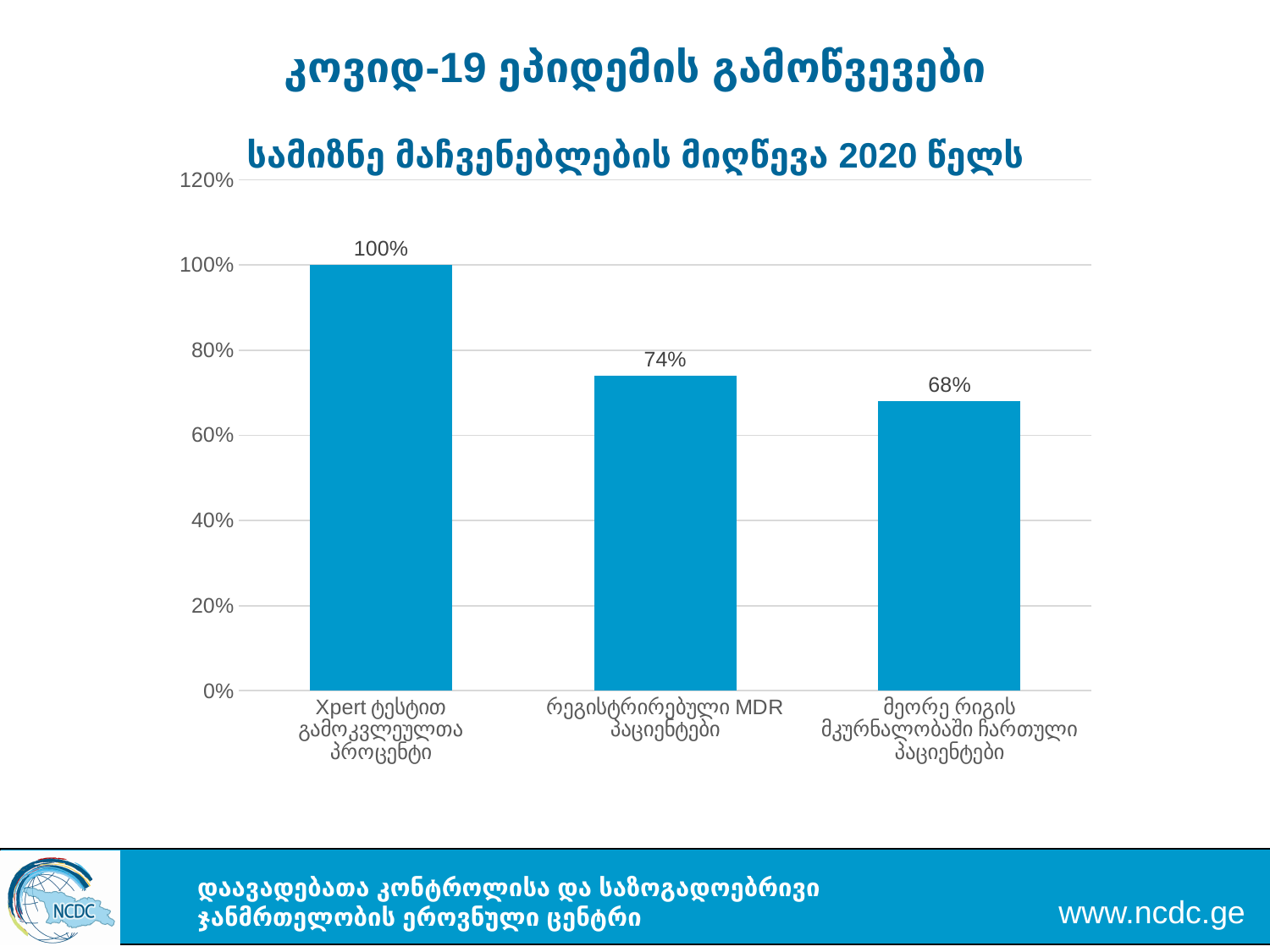
Which category has the lowest value? მეორე რიგის მკურნალობაში ჩართული პაციენტები Which category has the highest value? Xpert ტესტით გამოკვლეულთა პროცენტი What is the difference between the values for "Xpert ტესტით გამოკვლეულთა პროცენტი" and "რეგისტრირებული MDR პაციენტები"? 26% What is the difference between the values for "რეგისტრირებული MDR პაციენტები" and "მეორე რიგის მკურნალობაში ჩართული პაციენტები"? 6% What value is shown for the category "მეორე რიგის მკურნალობაში ჩართული პაციენტები"? 68% What kind of chart is shown on the slide? bar chart What value is shown for the category "რეგისტრირებული MDR პაციენტები"? 74% Which is larger: the value for "რეგისტრირებული MDR პაციენტები" or the value for "მეორე რიგის მკურნალობაში ჩართული პაციენტები"? რეგისტრირებული MDR პაციენტები How many categories are shown in the chart? 3 What is the title of the chart? სამიზნე მაჩვენებლების მიღწევა 2020 წელს What value is shown for the category "Xpert ტესტით გამოკვლეულთა პროცენტი"? 100% Is the value for "მეორე რიგის მკურნალობაში ჩართული პაციენტები" greater or less than 80%? less